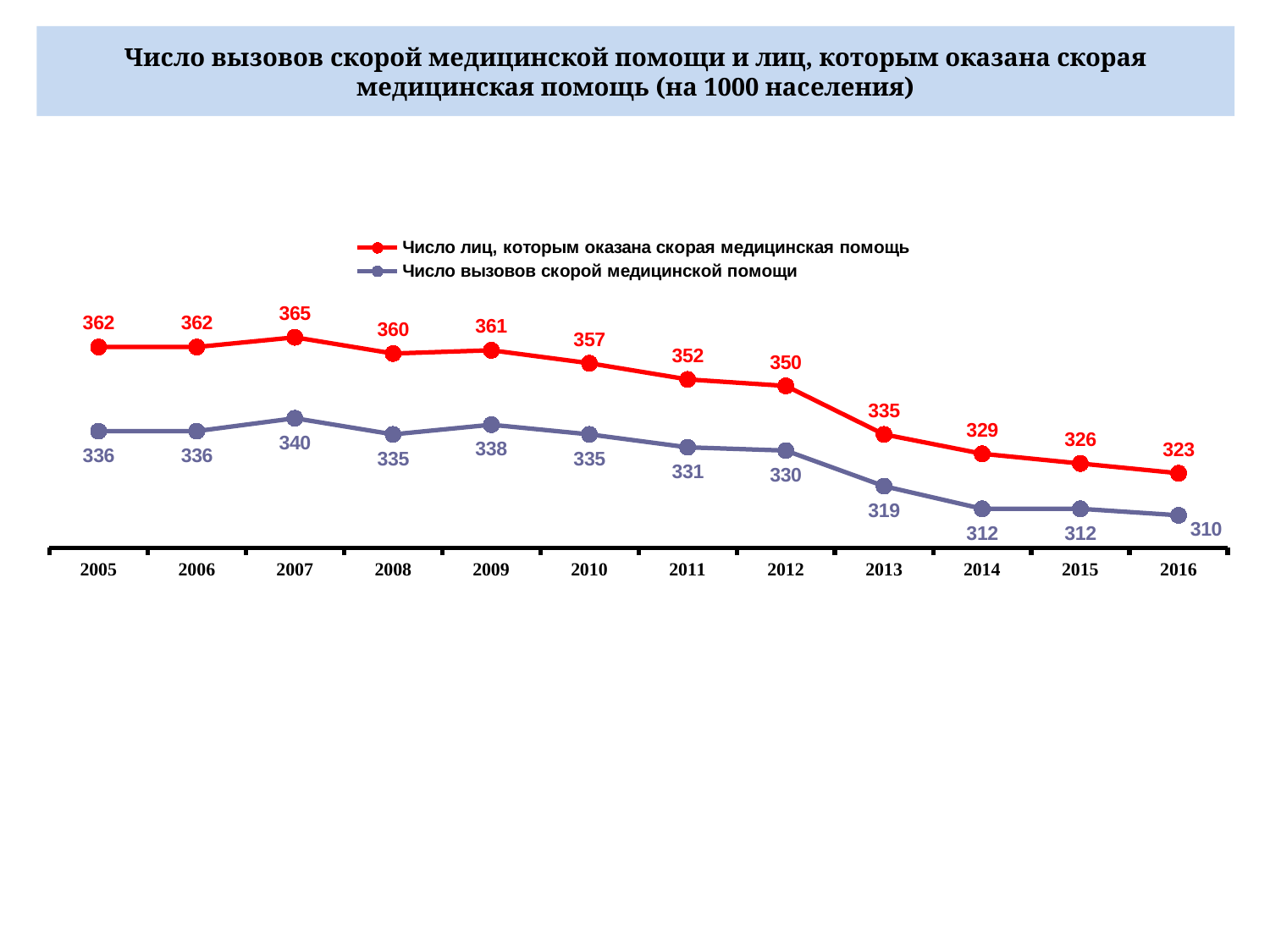
What is the difference between the two series in 2012? 20 What is the value of 'Число вызовов скорой медицинской помощи' in 2016? 310 Does 'Число вызовов скорой медицинской помощи' generally rise or fall from 2005 to 2016? fall In which year is 'Число вызовов скорой медицинской помощи' lowest? 2016 How many series does the legend list? 2 What colour is the line for 'Число лиц, которым оказана скорая медицинская помощь'? red What type of chart is shown on the slide? line chart In which year is 'Число лиц, которым оказана скорая медицинская помощь' highest? 2007 What is the value of 'Число лиц, которым оказана скорая медицинская помощь' in 2007? 365 Which is larger in 2014: 'Число лиц, которым оказана скорая медицинская помощь' or 'Число вызовов скорой медицинской помощи'? Число лиц, которым оказана скорая медицинская помощь How many years are shown on the x axis? 12 What is the value of 'Число вызовов скорой медицинской помощи' in 2013? 319